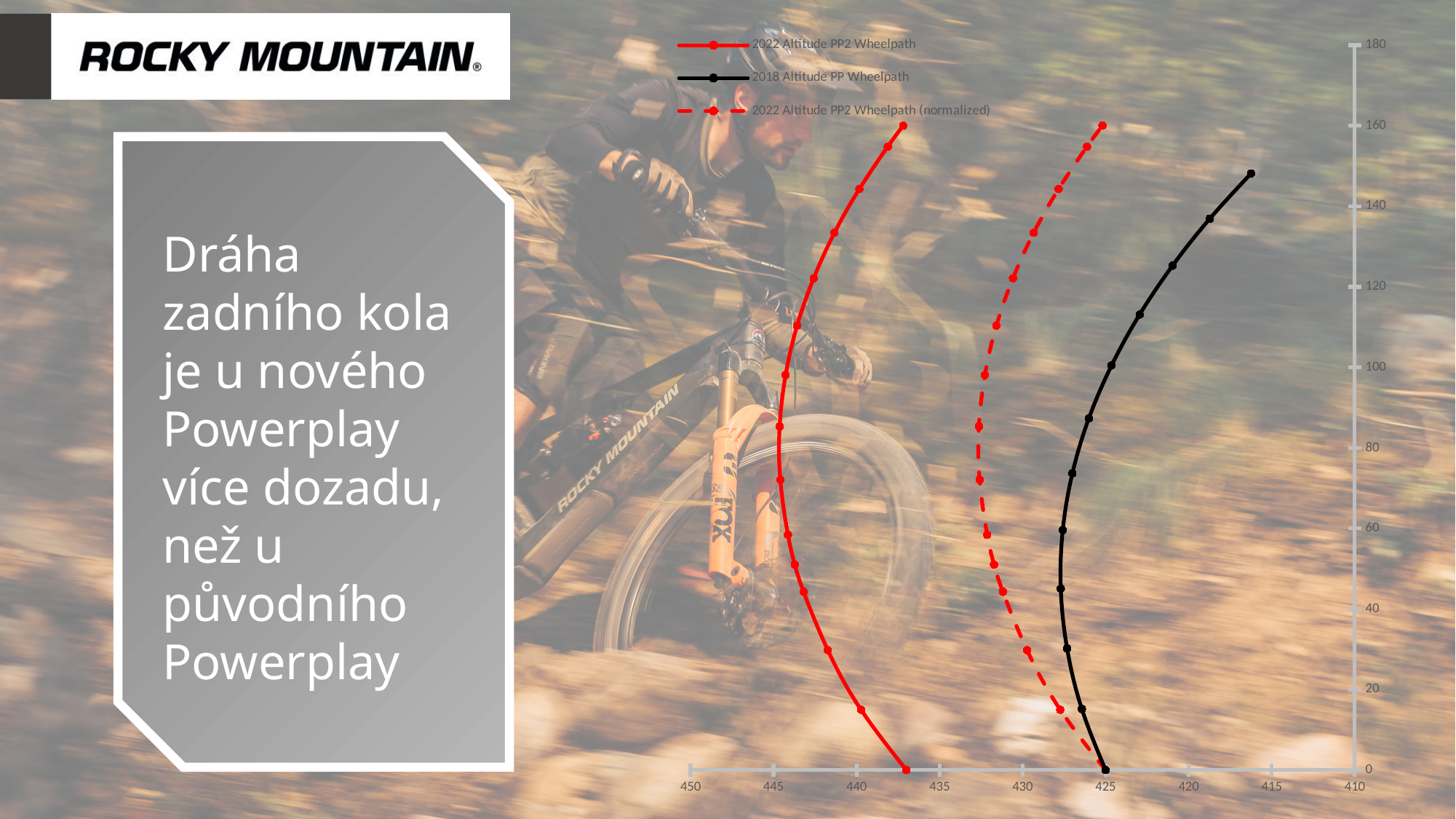
Is the horizontal-axis value of the bottom point (height 0) of the solid 2022 Altitude PP2 Wheelpath curve greater or less than 435? greater Which series in the legend is drawn with a dashed line? 2022 Altitude PP2 Wheelpath (normalized) What kind of chart is shown on the slide? line chart Is the horizontal-axis value of the bottom point (height 0) of the solid 2022 Altitude PP2 Wheelpath curve greater or less than 440? less Which series reaches a lower maximum height on the vertical axis: 2018 Altitude PP Wheelpath or the solid 2022 Altitude PP2 Wheelpath? 2018 Altitude PP Wheelpath What is the highest value shown on the vertical axis? 180 At which horizontal-axis value does the 2018 Altitude PP Wheelpath curve start at height 0? 425 Is the topmost point of the 2018 Altitude PP Wheelpath curve greater or less than 160 on the vertical axis? less Which series extends furthest toward the 450 end of the horizontal axis? 2022 Altitude PP2 Wheelpath How many series does the chart legend list? 3